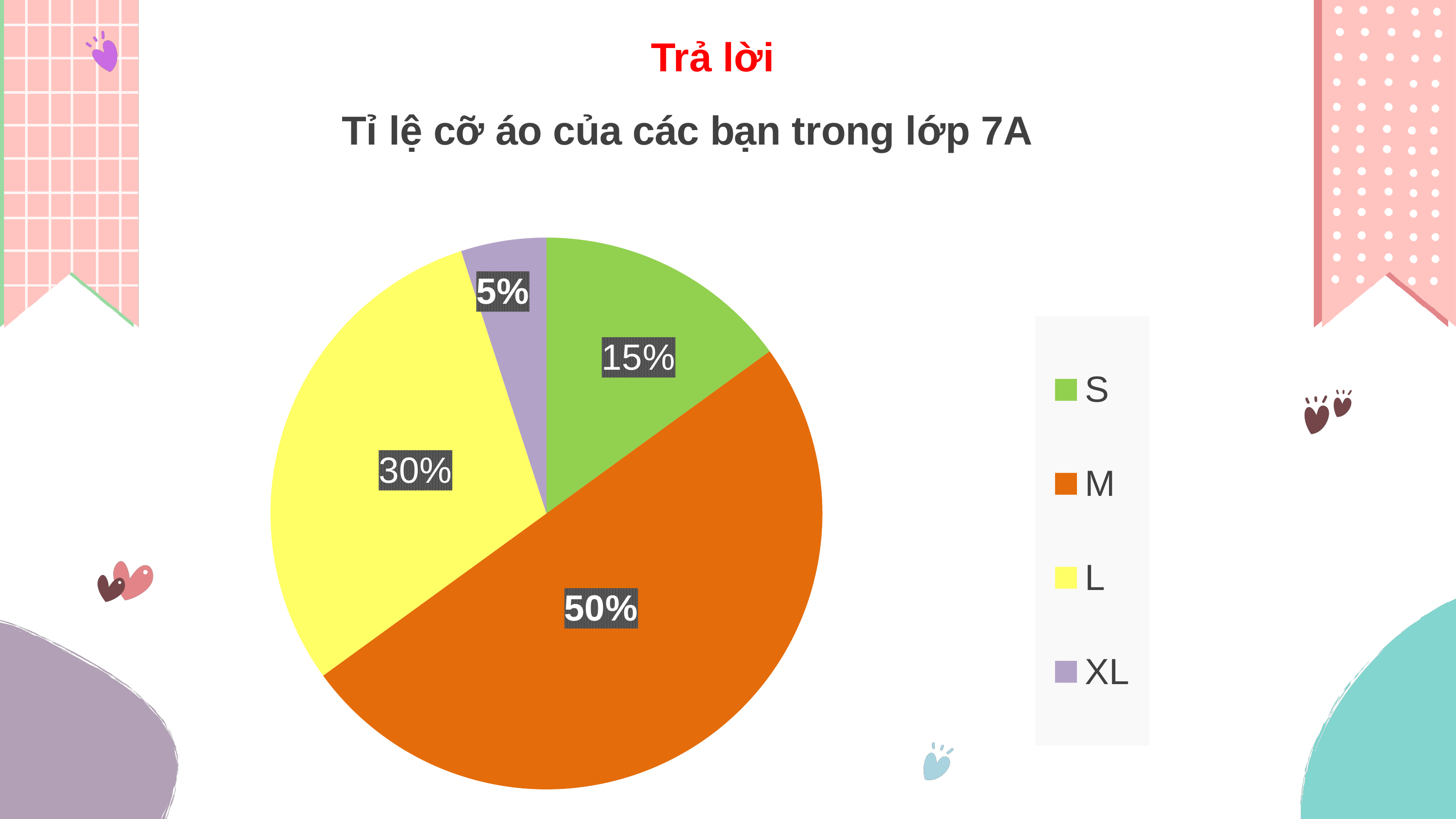
Which shirt size has the smallest share of the pie chart? XL What type of chart is shown on the slide? pie chart What percentage of the pie chart is size L? 30% Which shirt size has the largest share of the pie chart? M What is the difference in percentage points between size S and size XL? 10 Which has a larger share, size S or size L? L What colour represents size L in the pie chart? yellow What percentage of the pie chart is size S? 15% How many shirt sizes are shown in the pie chart? 4 What percentage of the pie chart is size M? 50% What is the difference in percentage points between size M and size L? 20 What percentage of the pie chart is size XL? 5%